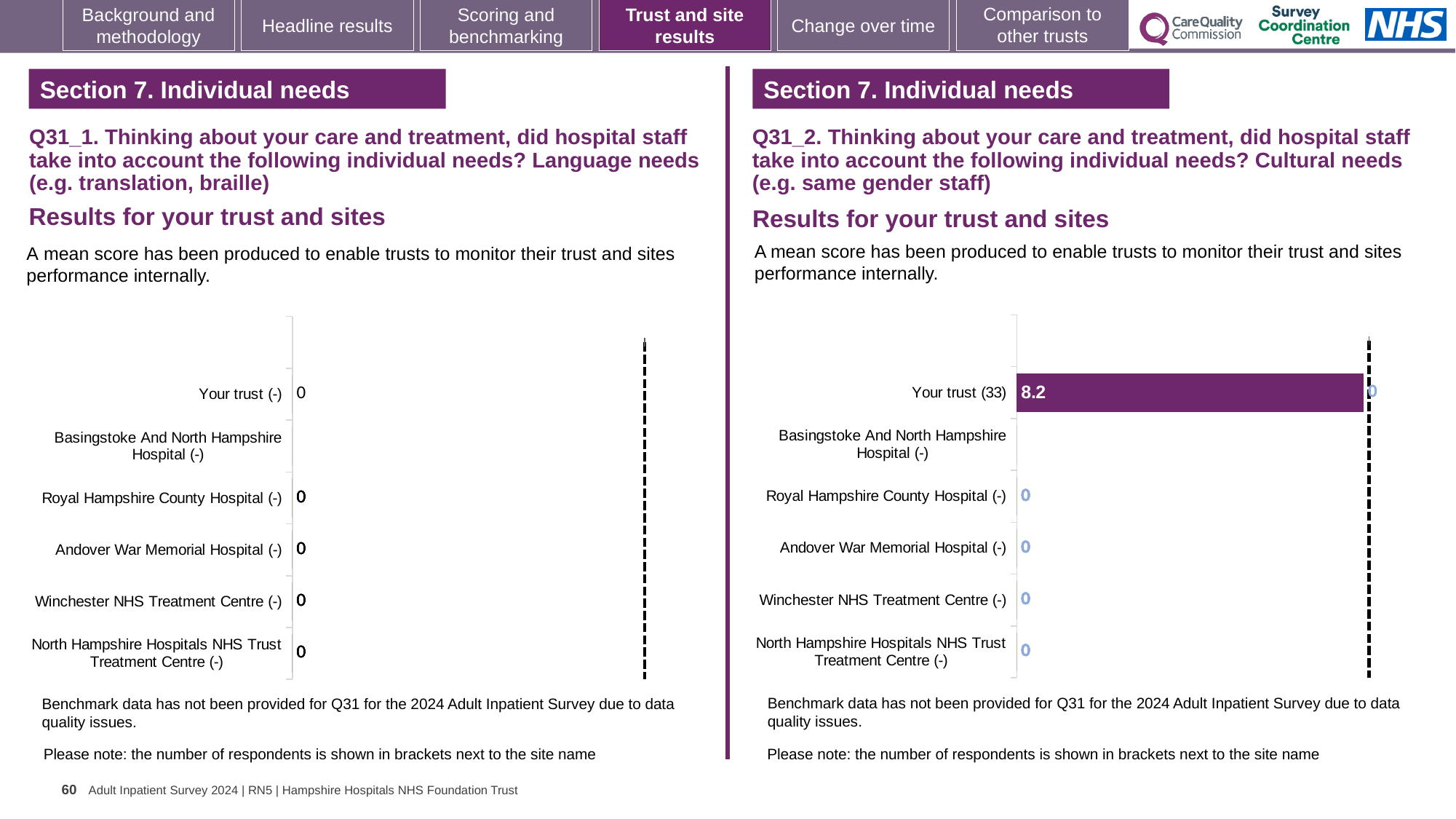
On the left chart (Q31_1, Language needs), what is the value for Royal Hampshire County Hospital (-)? 0 On the right chart (Q31_2, Cultural needs), which is larger: the value for Your trust (33) or the value for Royal Hampshire County Hospital (-)? Your trust (33) On the right chart (Q31_2, Cultural needs), which category has the highest value? Your trust (33) On the right chart (Q31_2, Cultural needs), what is the value for Winchester NHS Treatment Centre (-)? 0 On the left chart (Q31_1, Language needs), how many categories are listed on the vertical axis? 6 On the left chart (Q31_1, Language needs), what is the value for Your trust (-)? 0 On the left chart (Q31_1, Language needs), what is the value for North Hampshire Hospitals NHS Trust Treatment Centre (-)? 0 On the right chart (Q31_2, Cultural needs), how many categories are listed on the vertical axis? 6 On the right chart (Q31_2, Cultural needs), what is the value for Your trust (33)? 8.2 On the right chart (Q31_2, Cultural needs), what is the difference between the value for Your trust (33) and the value for Andover War Memorial Hospital (-)? 8.2 What kind of chart is used on the right side of the slide (Q31_2)? Bar chart On the right chart (Q31_2, Cultural needs), how many respondents are shown in brackets next to Your trust? 33